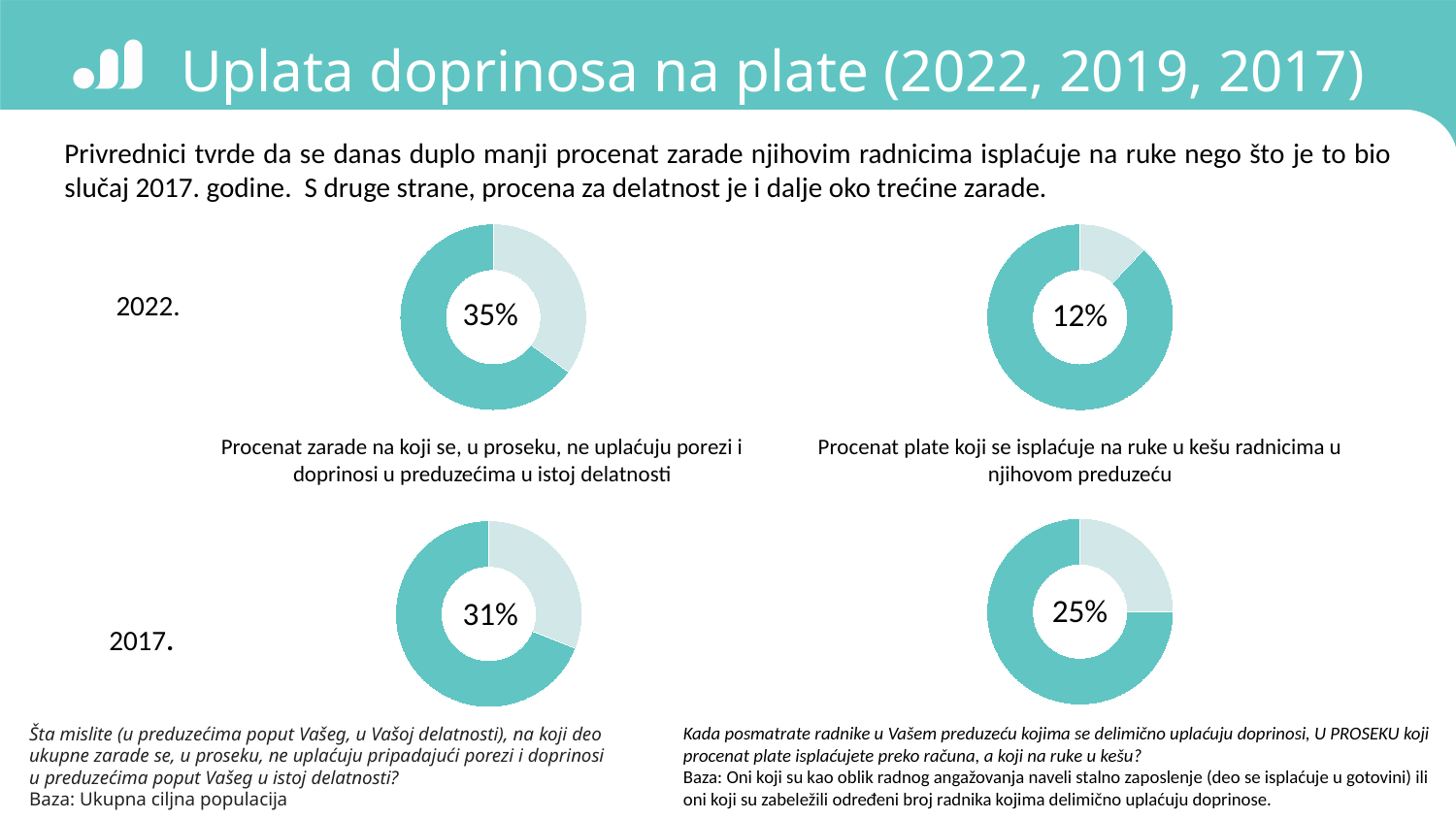
Of the four donut charts on the slide, which shows the lowest value? Top-right (2022, salary paid in cash), 12% On the bottom-left donut chart (2017, percentage of earnings on which taxes and contributions are not paid), what value is shown? 31% On the top-right donut chart (2022, percentage of salary paid in cash), what value is shown? 12% Which is larger: the 2022 value on the top-left chart or the 2022 value on the top-right chart? Top-left (35%) On the bottom-right donut chart (2017, percentage of salary paid in cash), what value is shown? 25% What type of chart is used to display the percentages on this slide? Donut (pie) chart Which is larger: the 2022 value for salary paid in cash (top-right chart) or the 2017 value for salary paid in cash (bottom-right chart)? 2017 (25%) Comparing the two right-hand donut charts (salary paid in cash), what is the difference between the 2017 value and the 2022 value? 13 percentage points How many donut charts are shown on the slide? 4 Comparing the two left-hand donut charts (earnings without taxes and contributions paid), what is the difference between the 2022 value and the 2017 value? 4 percentage points Of the four donut charts on the slide, which shows the highest value? Top-left (2022, earnings without taxes and contributions), 35% On the top-left donut chart (2022, percentage of earnings on which taxes and contributions are not paid), what value is shown? 35%